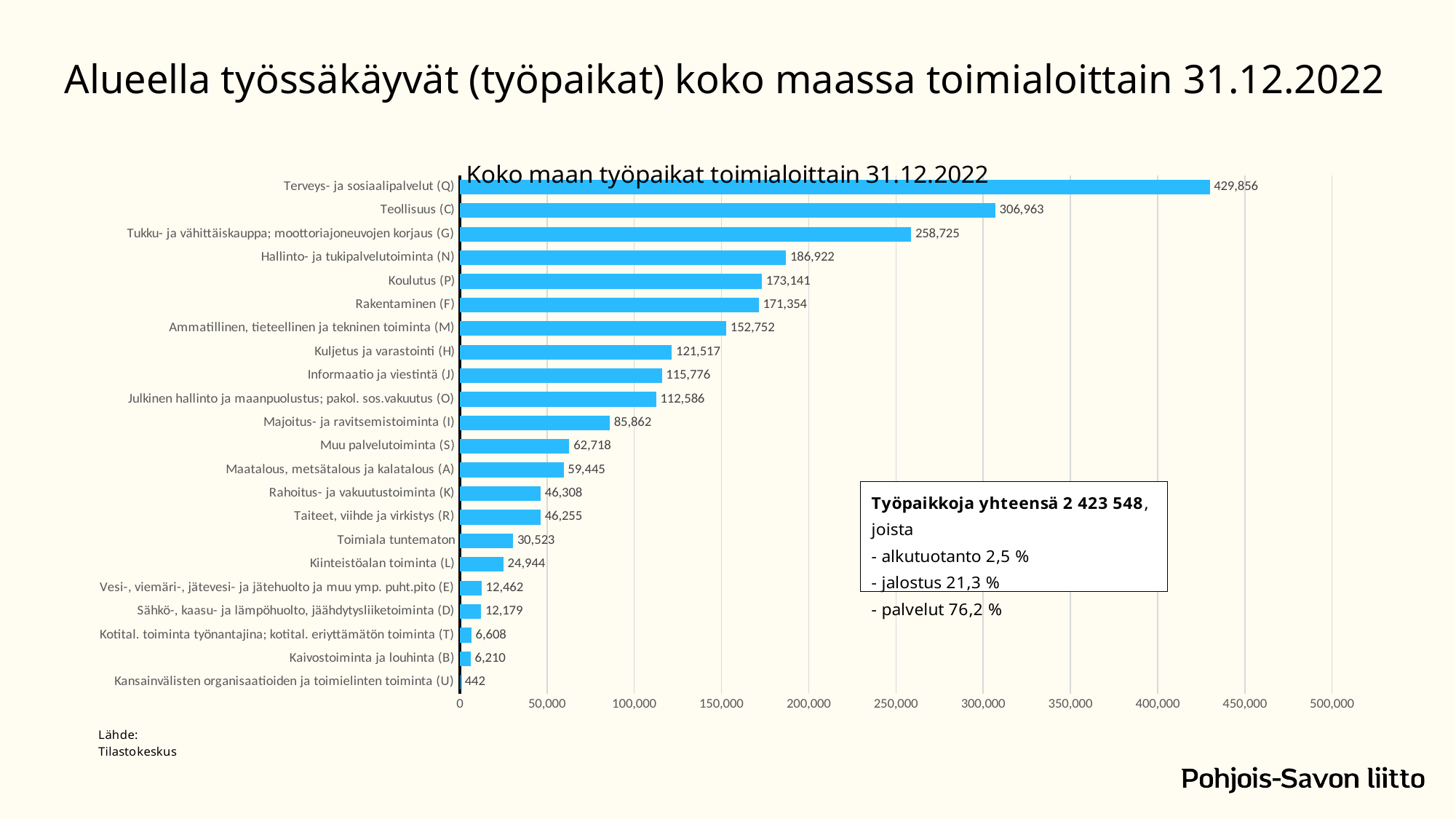
Which category has the lowest value? Kansainvälisten organisaatioiden ja toimielinten toiminta (U) What is the value for Koulutus (P)? 173,141 What is the title of the chart? Koko maan työpaikat toimialoittain 31.12.2022 Which category has the highest value? Terveys- ja sosiaalipalvelut (Q) How many categories are shown in the chart? 22 Which is larger, Kuljetus ja varastointi (H) or Informaatio ja viestintä (J)? Kuljetus ja varastointi (H) What is the value for Kiinteistöalan toiminta (L)? 24,944 What is the value for Terveys- ja sosiaalipalvelut (Q)? 429,856 Is the value for Majoitus- ja ravitsemistoiminta (I) greater or less than 50,000? greater What is the difference between Koulutus (P) and Rakentaminen (F)? 1,787 What kind of chart is shown on the slide? bar chart What is the difference between Teollisuus (C) and Tukku- ja vähittäiskauppa; moottoriajoneuvojen korjaus (G)? 48,238